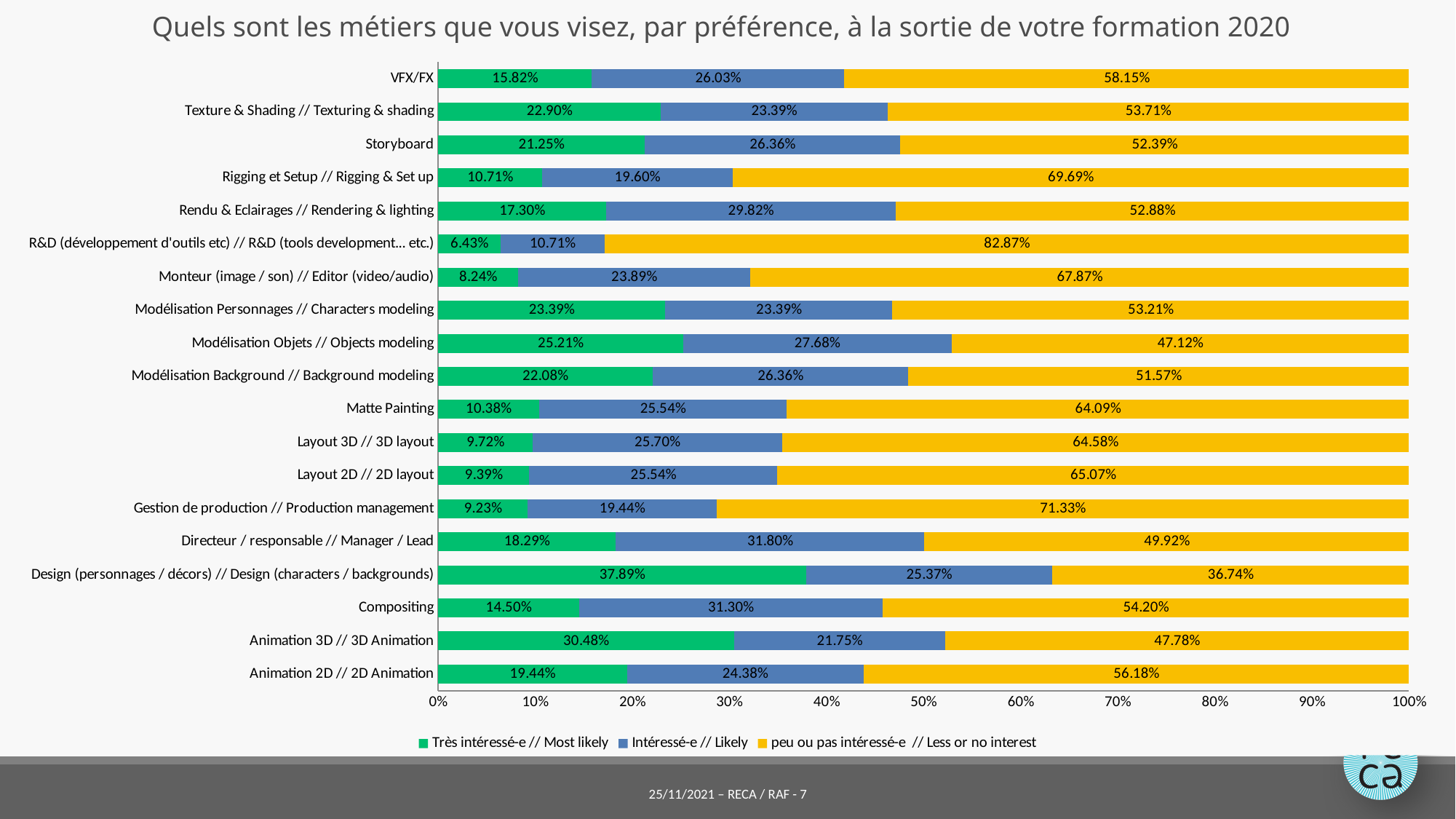
Which job has the highest 'Most likely' (Très intéressé-e) percentage? Design (personnages / décors) // Design (characters / backgrounds) What percentage of respondents are 'Most likely' (Très intéressé-e) to aim for Compositing? 14.50% What type of chart is shown on the slide? Stacked bar chart Which colour represents 'peu ou pas intéressé-e // Less or no interest' in the chart? Yellow Which has a higher 'Most likely' value: Storyboard or Matte Painting? Storyboard Which job has the lowest 'Less or no interest' percentage? Design (personnages / décors) // Design (characters / backgrounds) What is the 'Likely' (Intéressé-e) value for Directeur / responsable // Manager / Lead? 31.80% How many series does the legend list? 3 What is the 'Less or no interest' value for R&D (tools development)? 82.87% Which job has the lowest 'Most likely' (Très intéressé-e) percentage? R&D (développement d'outils etc) // R&D (tools development… etc.) How many job categories are shown on the chart? 19 What is the difference between the 'Most likely' values for Design (characters / backgrounds) and Animation 3D? 7.41 percentage points